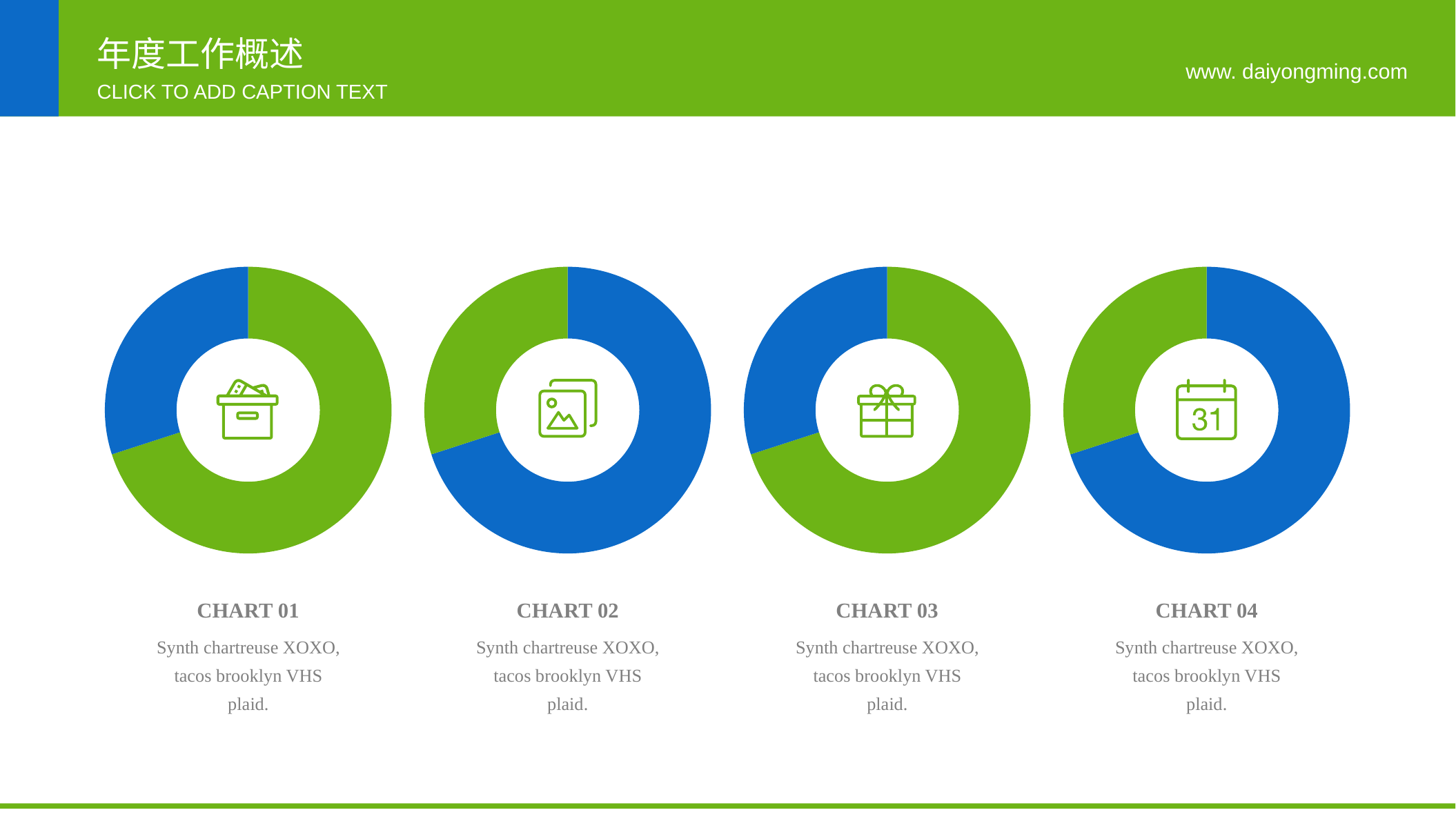
What two colours are used for the slices in the donut charts? Green and blue In CHART 02, which slice is larger, the green one or the blue one? Blue How many slices does the CHART 01 donut have? 2 How many slices does the CHART 03 donut have? 2 How many charts are shown on the slide? 4 In CHART 04, which slice is larger, the green one or the blue one? Blue In CHART 03, which slice is the largest? The green slice What kind of chart is CHART 01? Donut (pie) chart In CHART 02, which slice is the smallest? The green slice In CHART 01, which slice is larger, the green one or the blue one? Green What is the title printed under the third donut chart? CHART 03